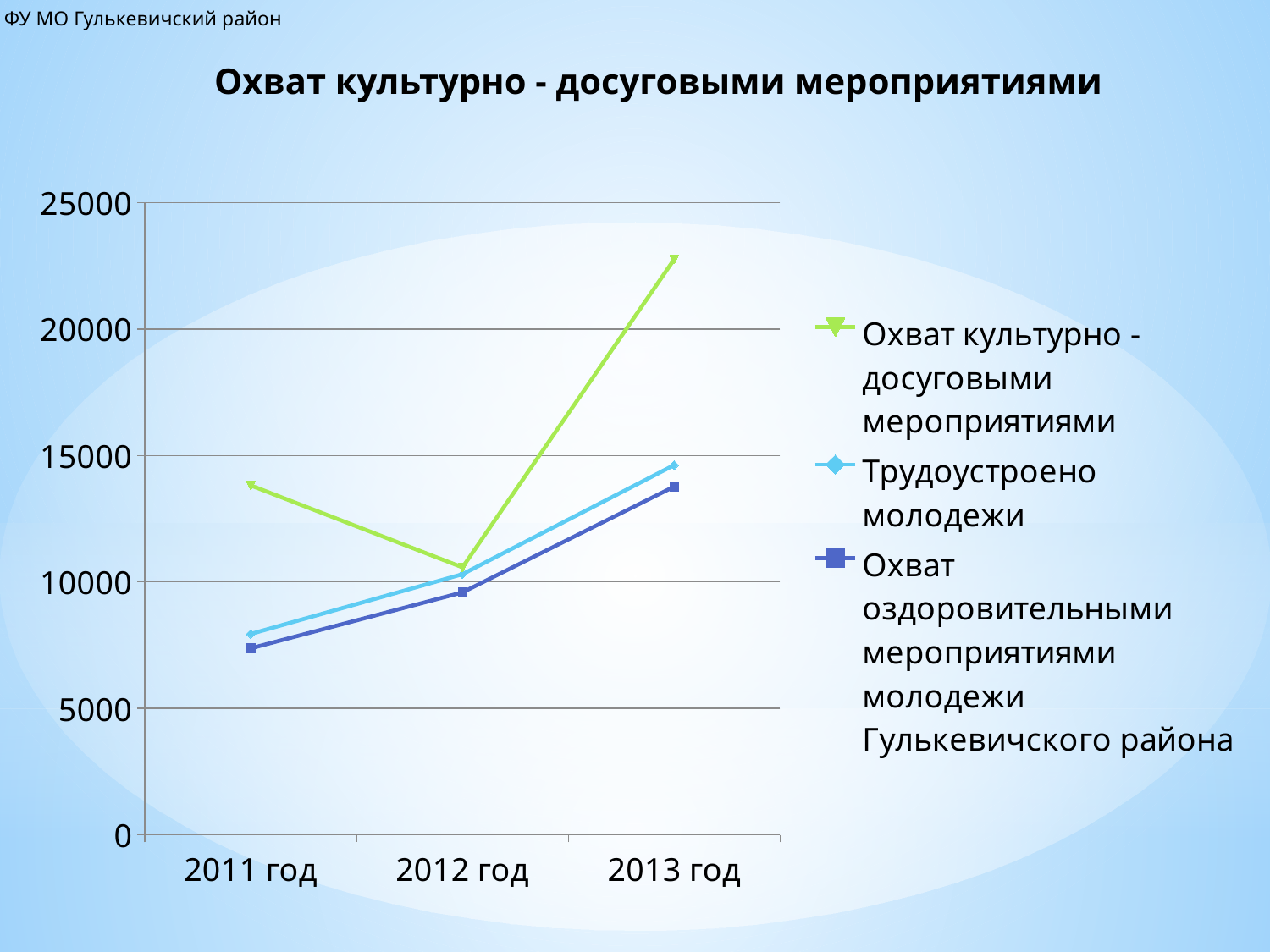
Is the value for 'Охват оздоровительными мероприятиями молодежи Гулькевичского района' in 2013 год greater or less than 15000? less What kind of chart is shown on the slide? line chart In which year is the value for 'Охват культурно - досуговыми мероприятиями' lowest? 2012 год Is the value for 'Трудоустроено молодежи' in 2011 год greater or less than 10000? less Is the value for 'Охват культурно - досуговыми мероприятиями' in 2013 год greater or less than 20000? greater How many series does the legend list? 3 In 2013 год, which series has the larger value: 'Охват культурно - досуговыми мероприятиями' or 'Трудоустроено молодежи'? Охват культурно - досуговыми мероприятиями Which series is drawn in green? Охват культурно - досуговыми мероприятиями What is the title of the chart? Охват культурно - досуговыми мероприятиями How many years are shown on the x axis? 3 In which year is the value for 'Охват культурно - досуговыми мероприятиями' highest? 2013 год Do the values for 'Охват оздоровительными мероприятиями молодежи Гулькевичского района' rise or fall from 2011 год to 2013 год? rise